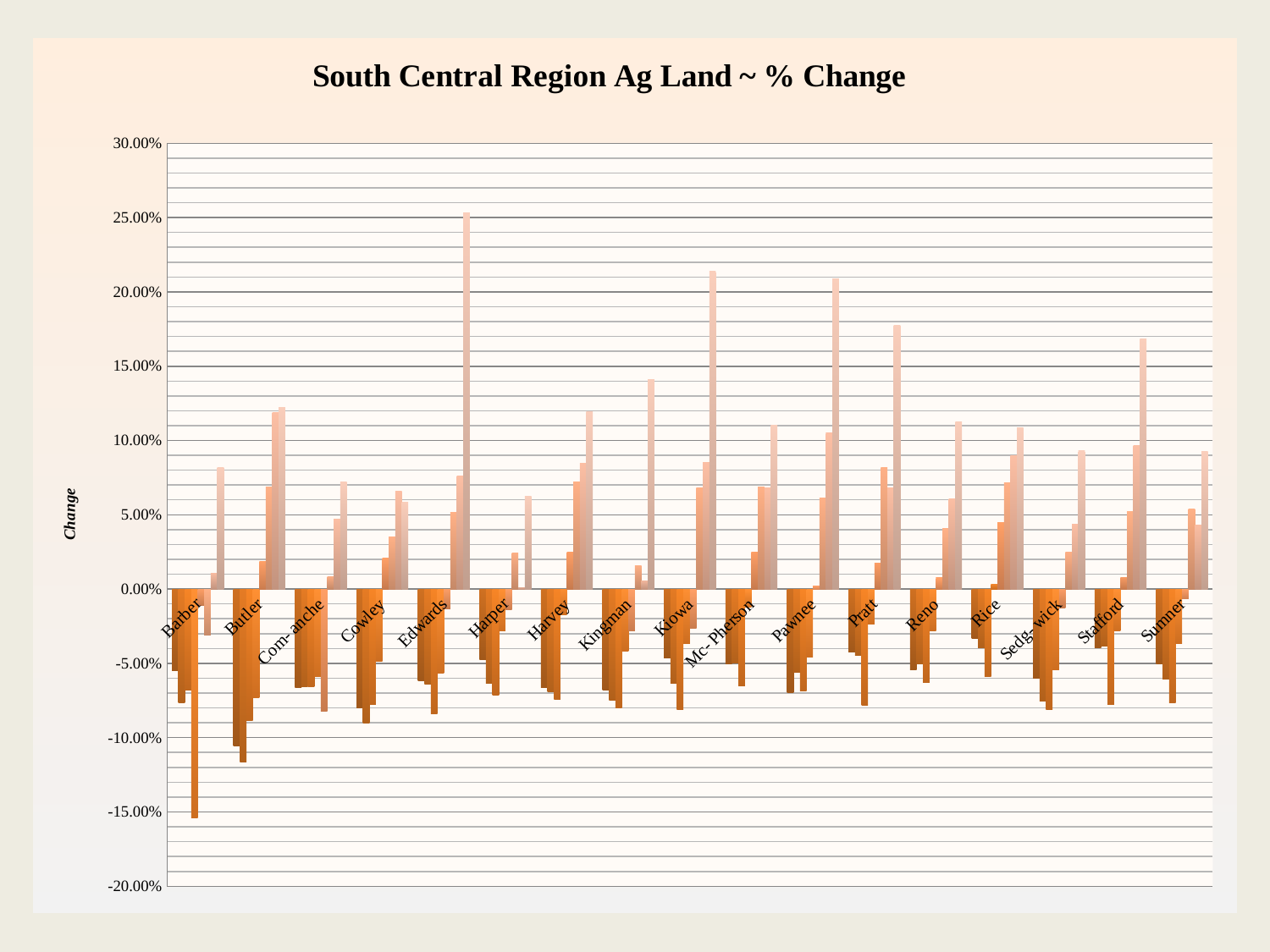
What is the highest value shown on the vertical axis of the chart? 30.00% Is the lowest bar for Barber greater or less than -10.00%? less How many counties (categories) are shown along the x axis of the chart? 17 Is the tallest bar for Stafford greater or less than 15.00%? greater Which county has the single tallest positive bar in the chart? Edwards Which is taller: the tallest bar for Edwards or the tallest bar for Mc-Pherson? Edwards What is the label on the vertical axis of the chart? Change Is the tallest bar for Edwards greater or less than 20.00%? greater What is the title of the chart? South Central Region Ag Land ~ % Change Which county has the single lowest negative bar in the chart? Barber What kind of chart is shown on the slide? bar chart